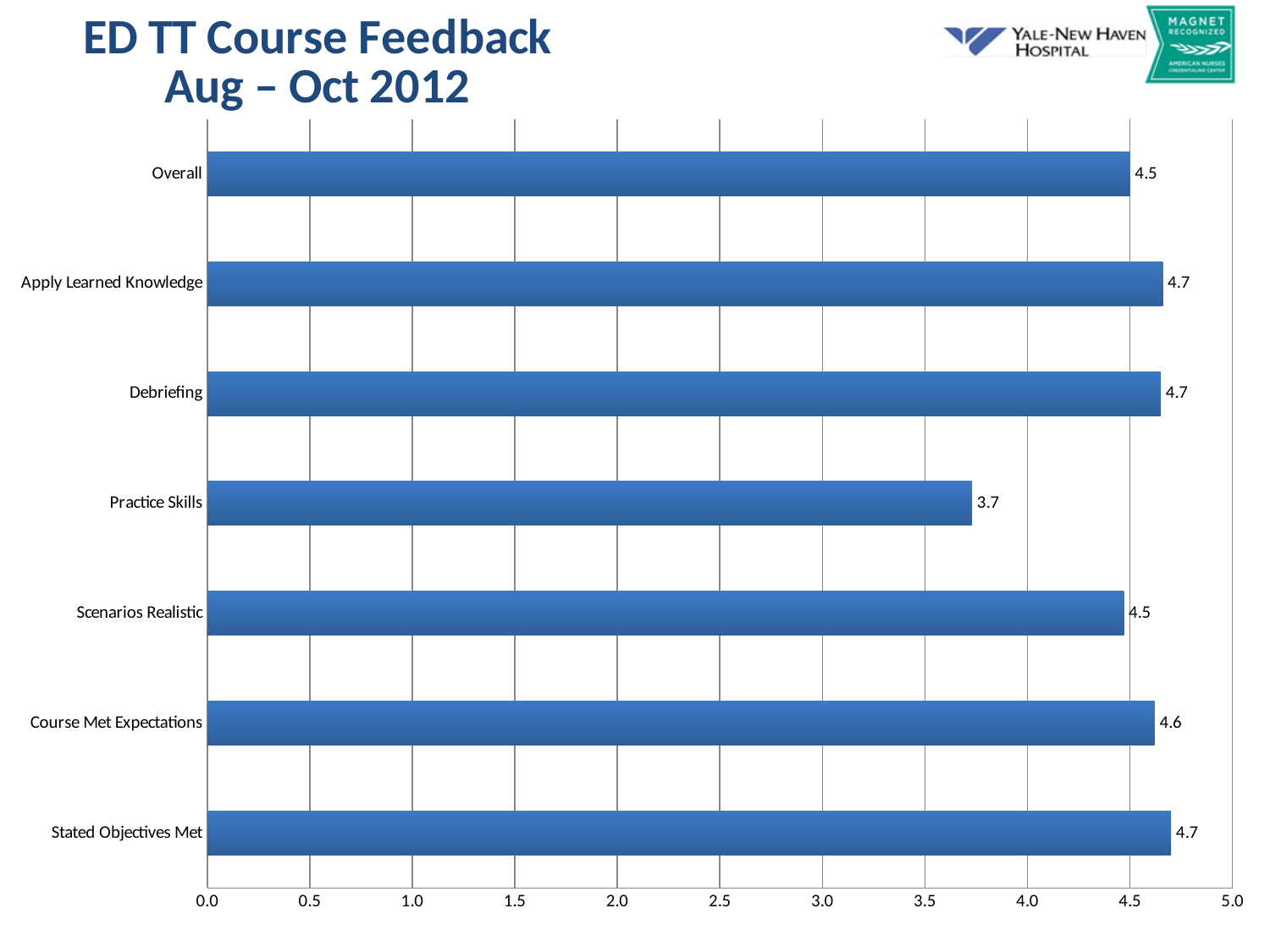
What is the value for Overall? 4.5 What is the value for Course Met Expectations? 4.6 What is the difference between the values for Course Met Expectations and Scenarios Realistic? 0.1 What is the value for Practice Skills? 3.7 What is the value for Stated Objectives Met? 4.7 Which category has the lowest value? Practice Skills What kind of chart is shown on the slide? bar chart What is the value for Debriefing? 4.7 What is the difference between the values for Apply Learned Knowledge and Practice Skills? 1.0 Which is larger, the value for Course Met Expectations or the value for Scenarios Realistic? Course Met Expectations How many categories are shown in the chart? 7 Is the value for Practice Skills greater or less than 4.0? less